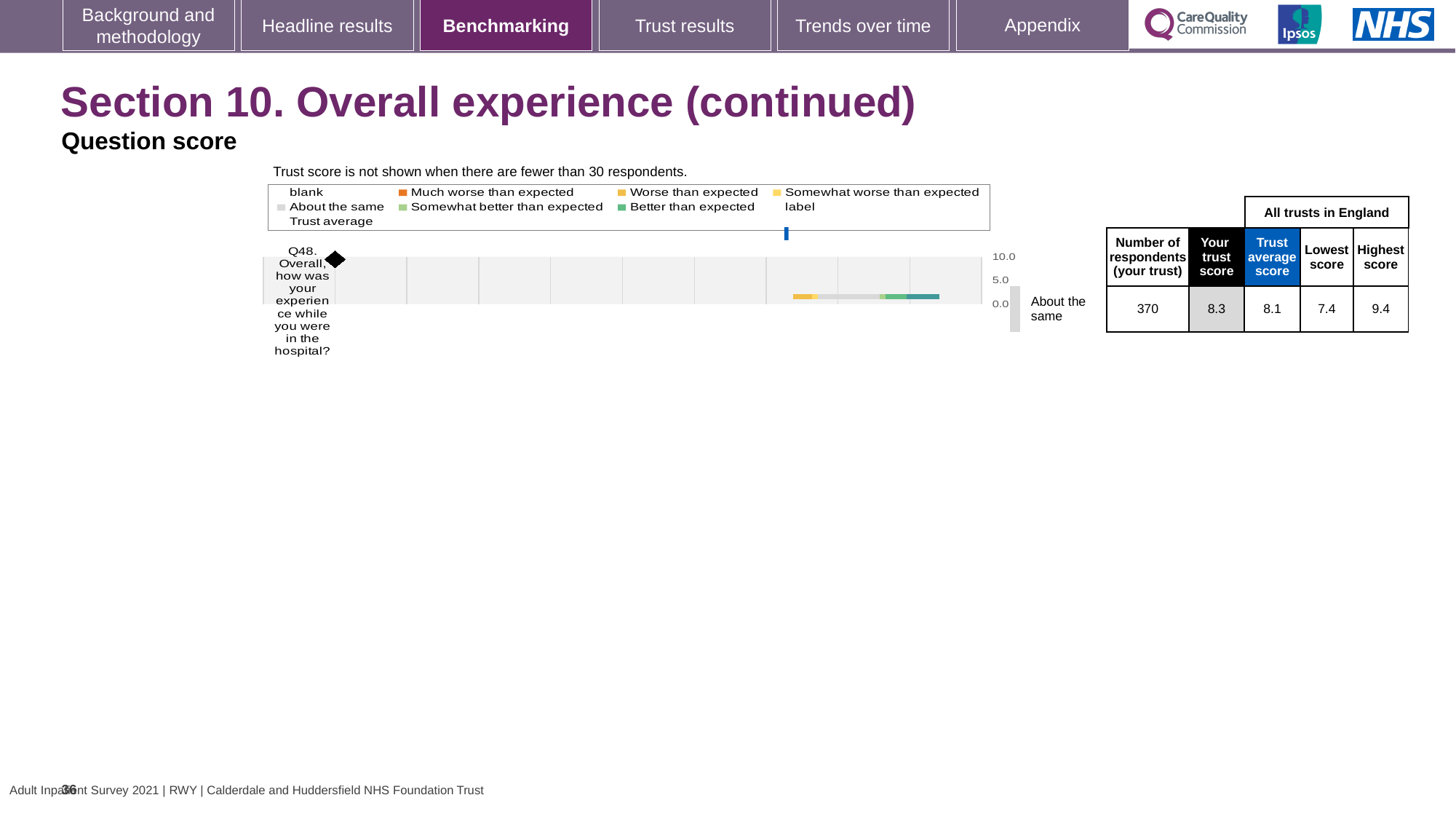
How many respondents from the trust answered Q48? 370 How many questions (categories) are plotted in the chart? 1 What colour does the legend use for 'Much worse than expected'? orange What is the difference between the highest and lowest scores among all trusts in England for Q48? 2.0 Which question is plotted in the chart? Q48. Overall, how was your experience while you were in the hospital? What is the highest score among all trusts in England for Q48? 9.4 What is the trust average score for Q48 across all trusts in England? 8.1 Is the trust score for Q48 greater or less than 5.0 on the chart axis? greater Which is larger for Q48: the trust score or the trust average score? the trust score What is the trust score for Q48? 8.3 What is the lowest score among all trusts in England for Q48? 7.4 What kind of chart is shown on the slide for Q48? bar chart